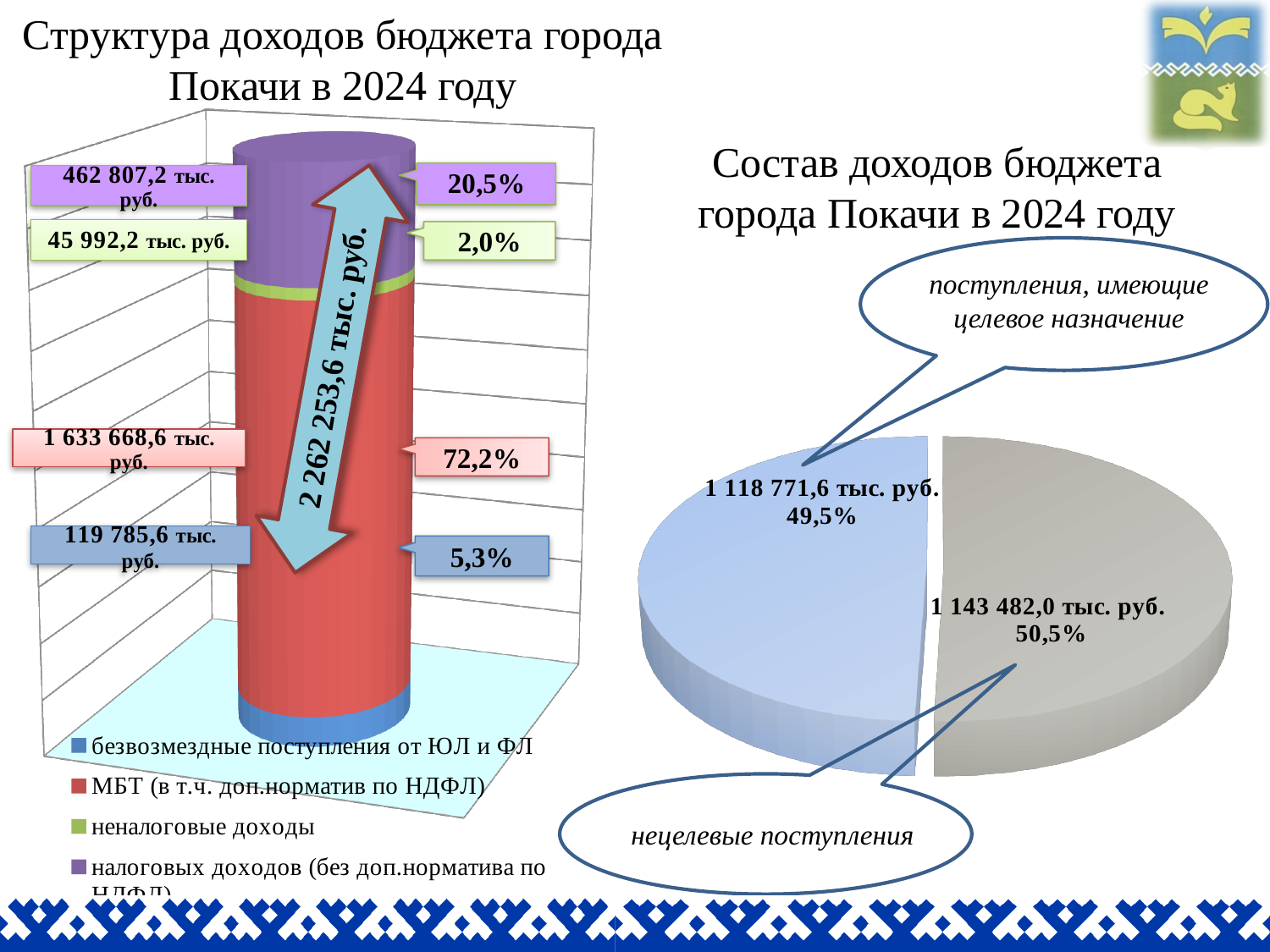
On the left chart (Структура доходов бюджета города Покачи в 2024 году), what is the value for МБТ (в т.ч. доп.норматив по НДФЛ)? 1 633 668,6 тыс. руб. On the left chart, which legend category has the largest share? МБТ (в т.ч. доп.норматив по НДФЛ) On the left chart, which legend category has the smallest share? неналоговые доходы On the right chart, what share of the pie do поступления, имеющие целевое назначение make up? 49,5% On the left chart, how many categories does the legend list? 4 On the left chart, what is the value for безвозмездные поступления от ЮЛ и ФЛ? 119 785,6 тыс. руб. On the left chart, what percentage share is shown for неналоговые доходы? 2,0% On the left chart, what percentage is shown for налоговых доходов (без доп.норматива по НДФЛ)? 20,5% What kind of chart is shown on the right side of the slide? pie chart On the right chart (Состав доходов бюджета города Покачи в 2024 году), what is the value for нецелевые поступления? 1 143 482,0 тыс. руб. On the left chart, what is the difference in percentage points between the МБТ share (72,2%) and the налоговых доходов share (20,5%)? 51,7 On the left chart, what is the total of the stacked bar as labelled on the arrow? 2 262 253,6 тыс. руб.